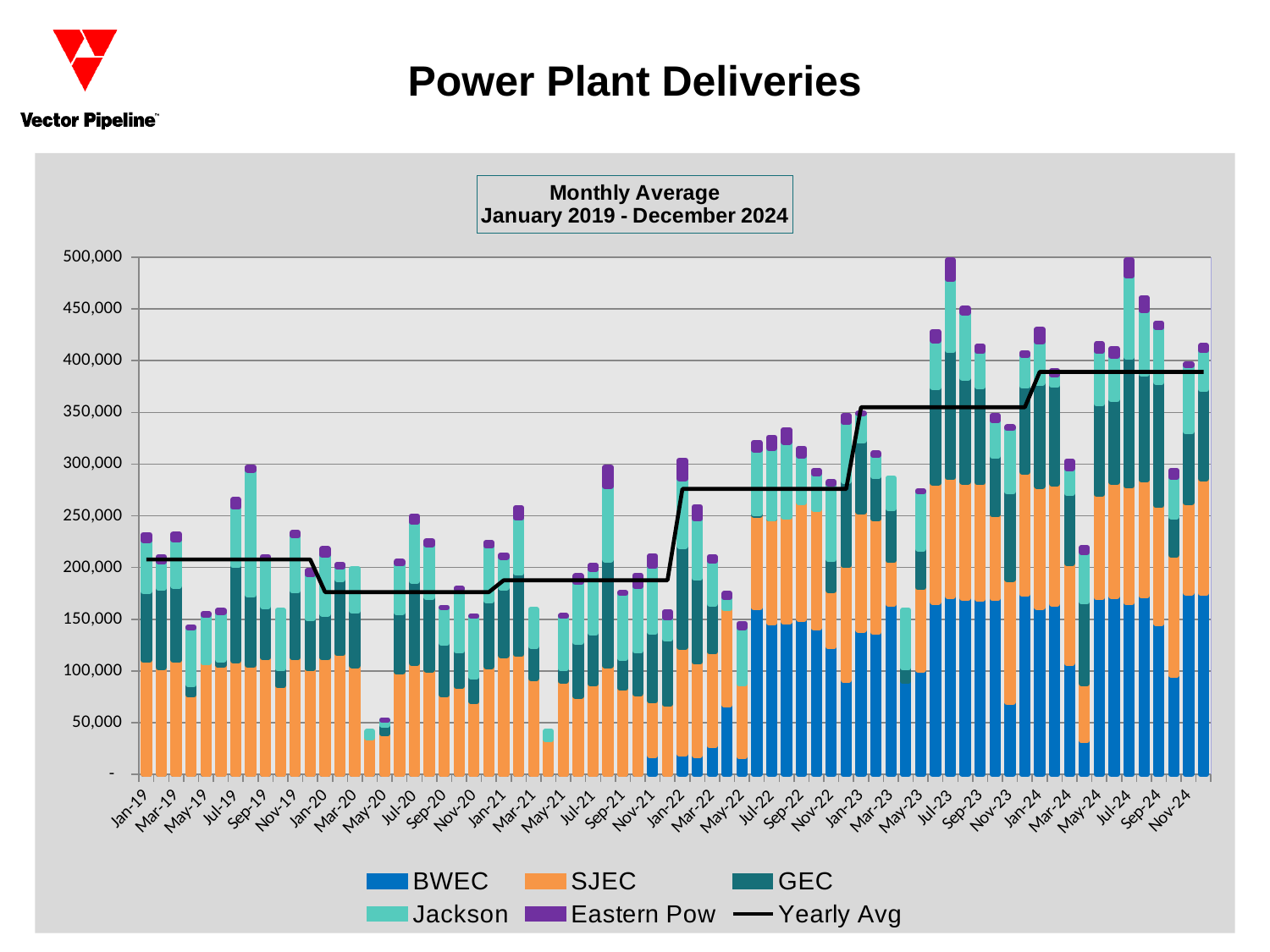
Which month has the larger total stacked bar, Jan-22 or Jan-19? Jan-22 Is the total stacked value for Jan-19 greater or less than 200,000? greater Is the Yearly Avg line for 2024 greater or less than 350,000? greater Does the Yearly Avg line end higher or lower in 2024 than it starts in 2019? higher Is the total stacked value for Jul-23 greater or less than 450,000? greater Which legend entry is drawn as a black line rather than a bar segment? Yearly Avg How many series does the legend list? 6 What kind of chart is shown on the slide? Stacked bar chart with a line Which month has the larger total stacked bar, Jul-23 or May-20? Jul-23 What is the title shown inside the chart area? Monthly Average January 2019 - December 2024